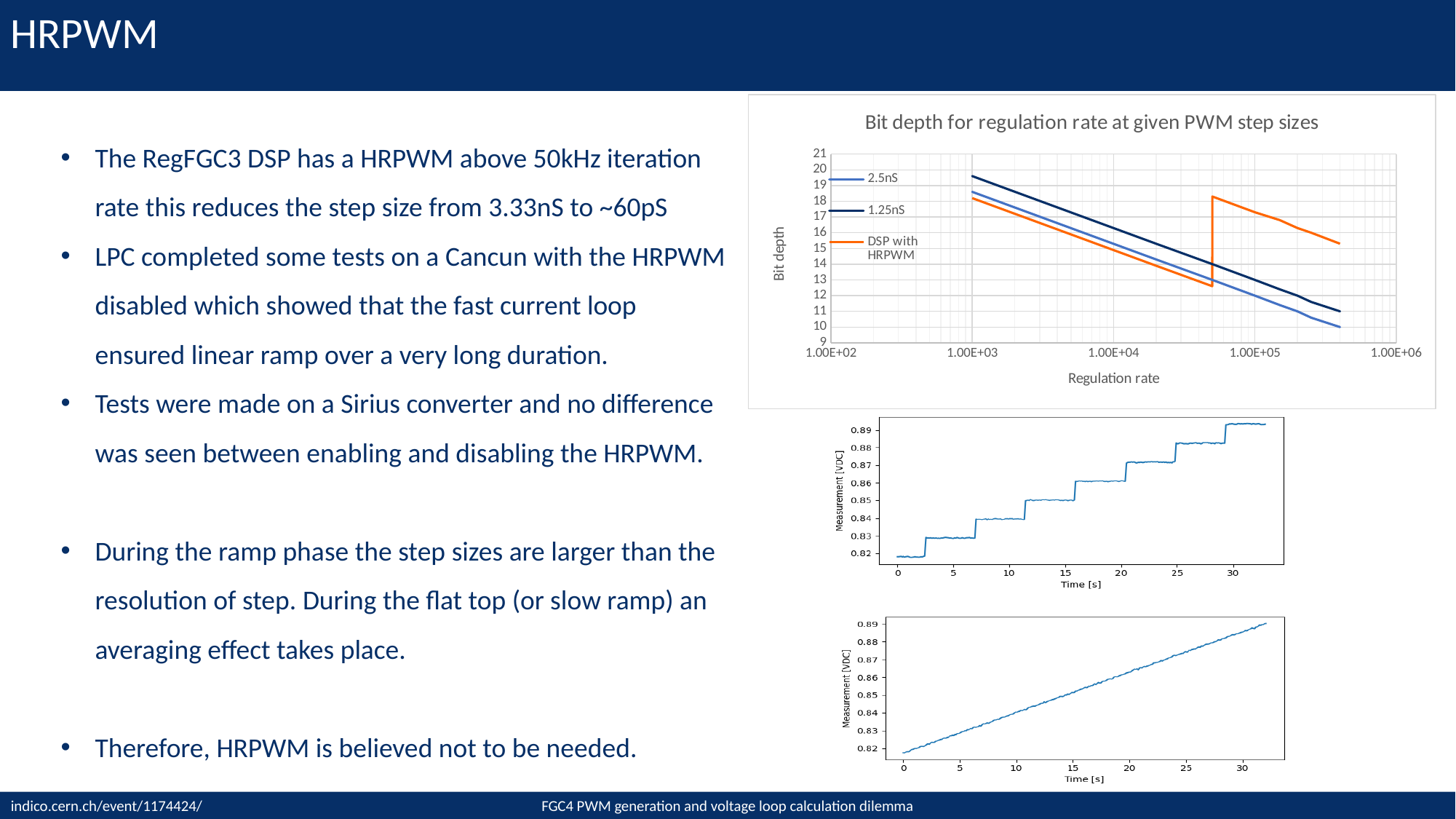
In the 'Bit depth for regulation rate at given PWM step sizes' chart, is the bit depth of the DSP with HRPWM series at its right-hand end greater or less than 14? greater In the bottom chart on the right (Measurement [VDC] vs Time [s]), is the measurement at 15 s greater or less than 0.84? greater In the 'Bit depth for regulation rate at given PWM step sizes' chart, which series has the highest bit depth at the right-hand end of the plotted lines? DSP with HRPWM In the 'Bit depth for regulation rate at given PWM step sizes' chart, is the bit depth of the 2.5nS series at its right-hand end greater or less than 12? less In the 'Bit depth for regulation rate at given PWM step sizes' chart, does the bit depth for the 2.5nS series rise or fall as the regulation rate increases? fall In the 'Bit depth for regulation rate at given PWM step sizes' chart, at a regulation rate of 1.00E+03, which series has the higher bit depth, 1.25nS or 2.5nS? 1.25nS What are the legend entries of the 'Bit depth for regulation rate at given PWM step sizes' chart? 2.5nS, 1.25nS, DSP with HRPWM How many series does the legend of the 'Bit depth for regulation rate at given PWM step sizes' chart list? 3 In the middle chart on the right (Measurement [VDC] vs Time [s]), does the measurement rise or fall over time? rise In the 'Bit depth for regulation rate at given PWM step sizes' chart, what is the title of the x axis? Regulation rate What kind of chart is the 'Bit depth for regulation rate at given PWM step sizes' chart? line chart